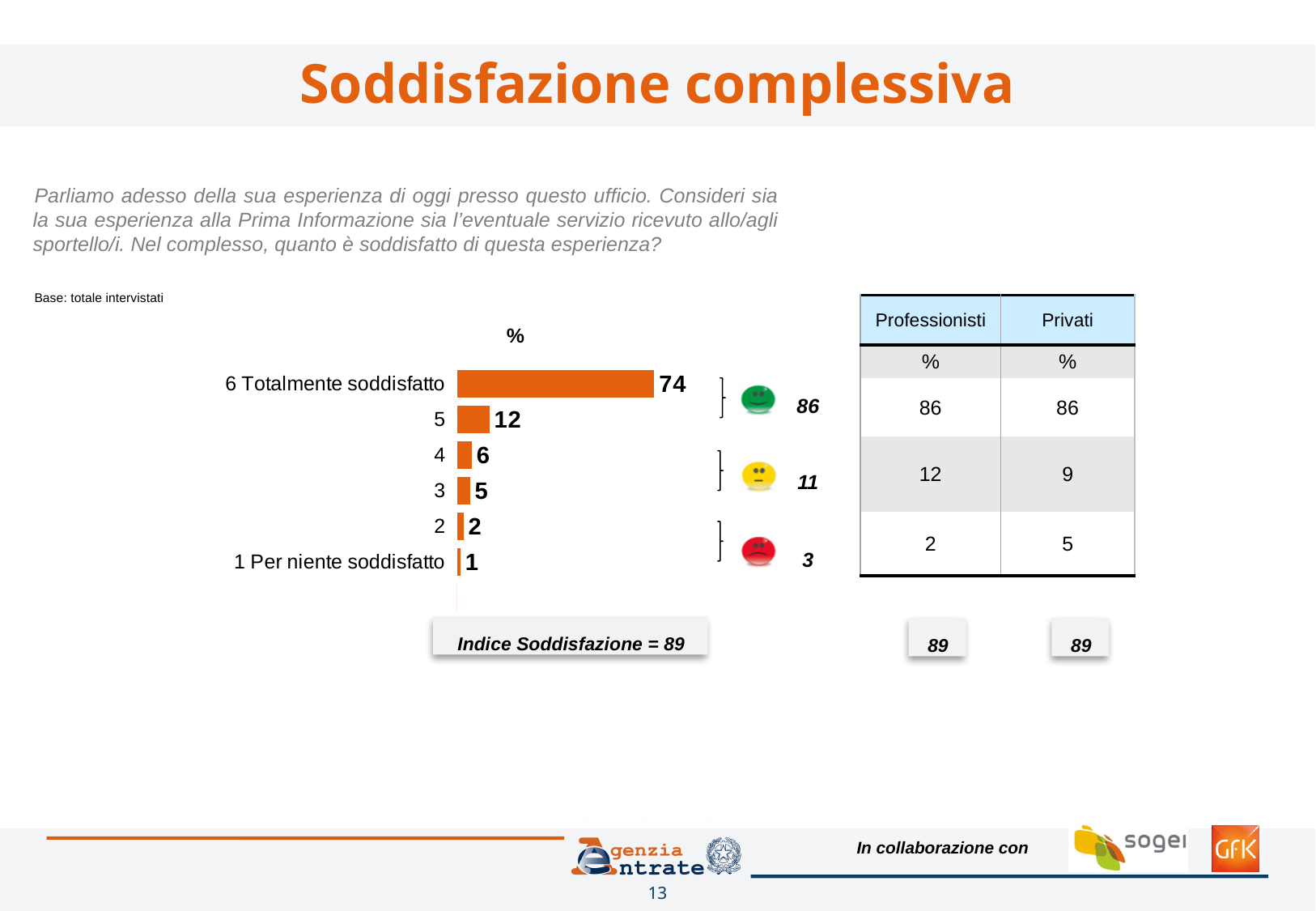
What is the value for "6 Totalmente soddisfatto"? 74 What is the Indice Soddisfazione shown below the chart? 89 What is the combined value for categories 6 and 5 shown next to the green face? 86 What is the value for "1 Per niente soddisfatto"? 1 Which category has the highest value? 6 Totalmente soddisfatto How many categories are shown in the bar chart? 6 Which is larger, the value for category 4 or category 3? Category 4 Which category has the lowest value? 1 Per niente soddisfatto What is the difference between the values for category 6 and category 5? 62 What is the value for category 5? 12 What kind of chart is shown on the slide? Bar chart What is the value for category 4? 6